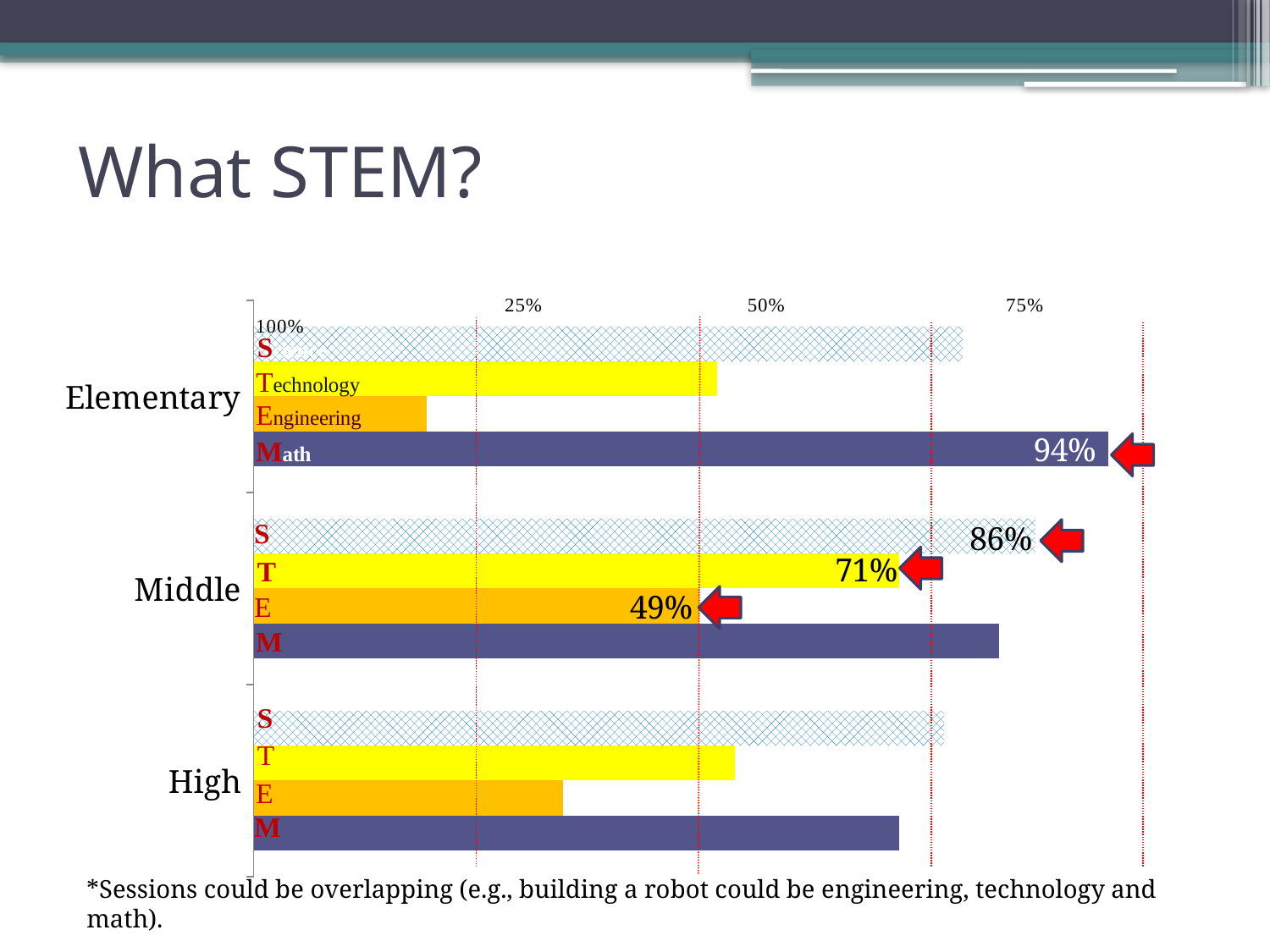
What is the value for Math in the Elementary group? 94% What is the value for Science in the Middle group? 86% Is the value for Math in the High group greater or less than 50%? greater Which is larger, the Middle Technology value or the Middle Engineering value? Middle Technology Within the Middle group, which subject has the lowest value? Engineering What is the difference between the Elementary Math value and the Middle Science value? 8% What is the difference between the Middle Science value and the Middle Engineering value? 37% What kind of chart is shown on the slide? Bar chart What is the value for Technology in the Middle group? 71% What is the value for Engineering in the Middle group? 49% Is the value for Engineering in the Elementary group greater or less than 25%? less How many grade-level groups are shown on the chart? 3